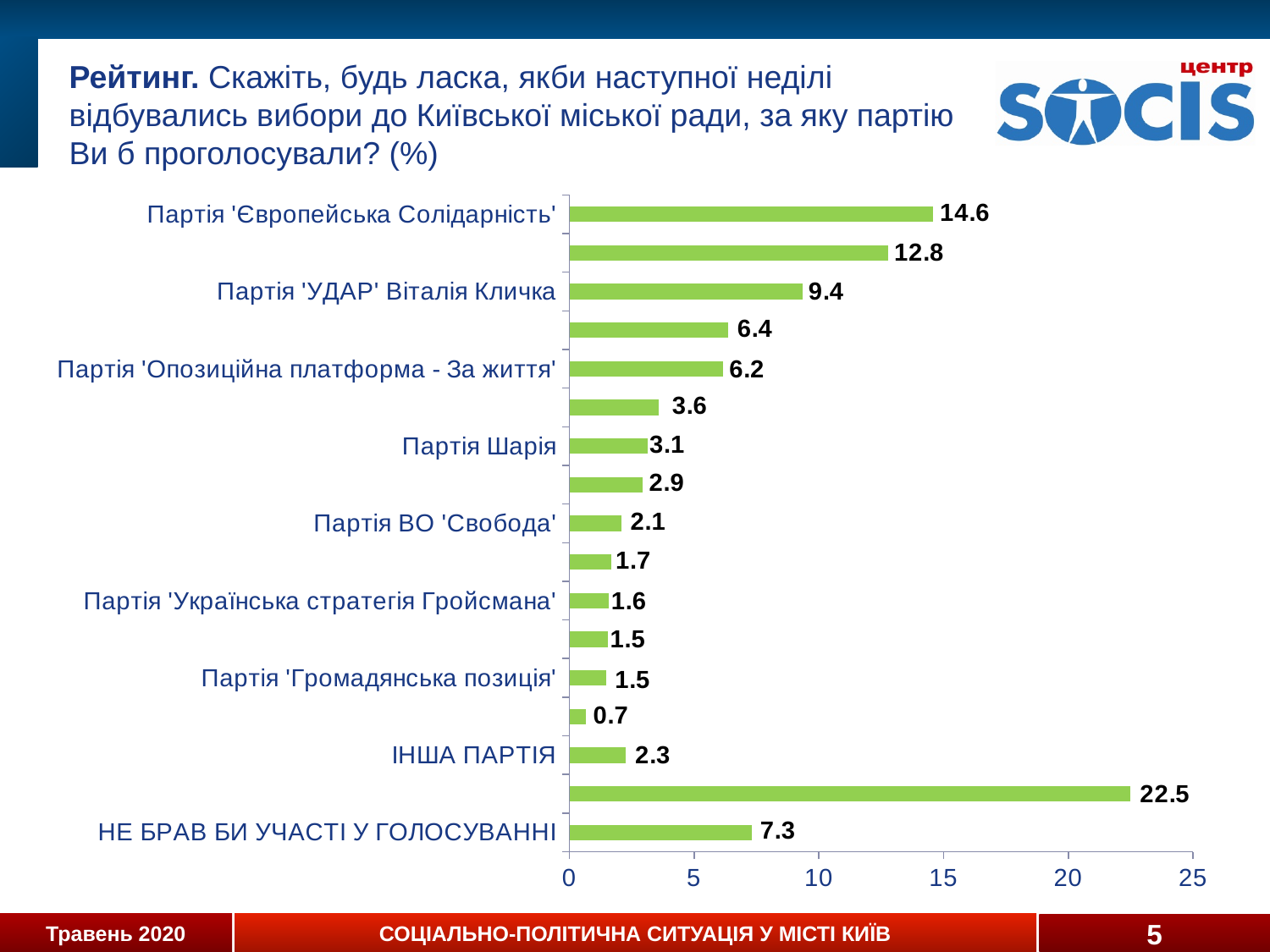
What value is shown for Партія 'УДАР' Віталія Кличка? 9.4 Is the value for Партія 'Європейська Солідарність' greater or less than 10? greater What value is shown for ІНША ПАРТІЯ? 2.3 What value is shown for Партія 'Європейська Солідарність'? 14.6 What kind of chart is shown on the slide? bar chart What value is shown for Партія 'Опозиційна платформа - За життя'? 6.2 What value is shown for НЕ БРАВ БИ УЧАСТІ У ГОЛОСУВАННІ? 7.3 What is the maximum value shown on the horizontal axis? 25 How many bars are plotted in the chart? 17 What value is shown for Партія Шарія? 3.1 Which is larger, the value for Партія ВО 'Свобода' or the value for Партія 'Українська стратегія Гройсмана'? Партія ВО 'Свобода' What is the difference between the values for Партія 'Європейська Солідарність' and Партія 'УДАР' Віталія Кличка? 5.2